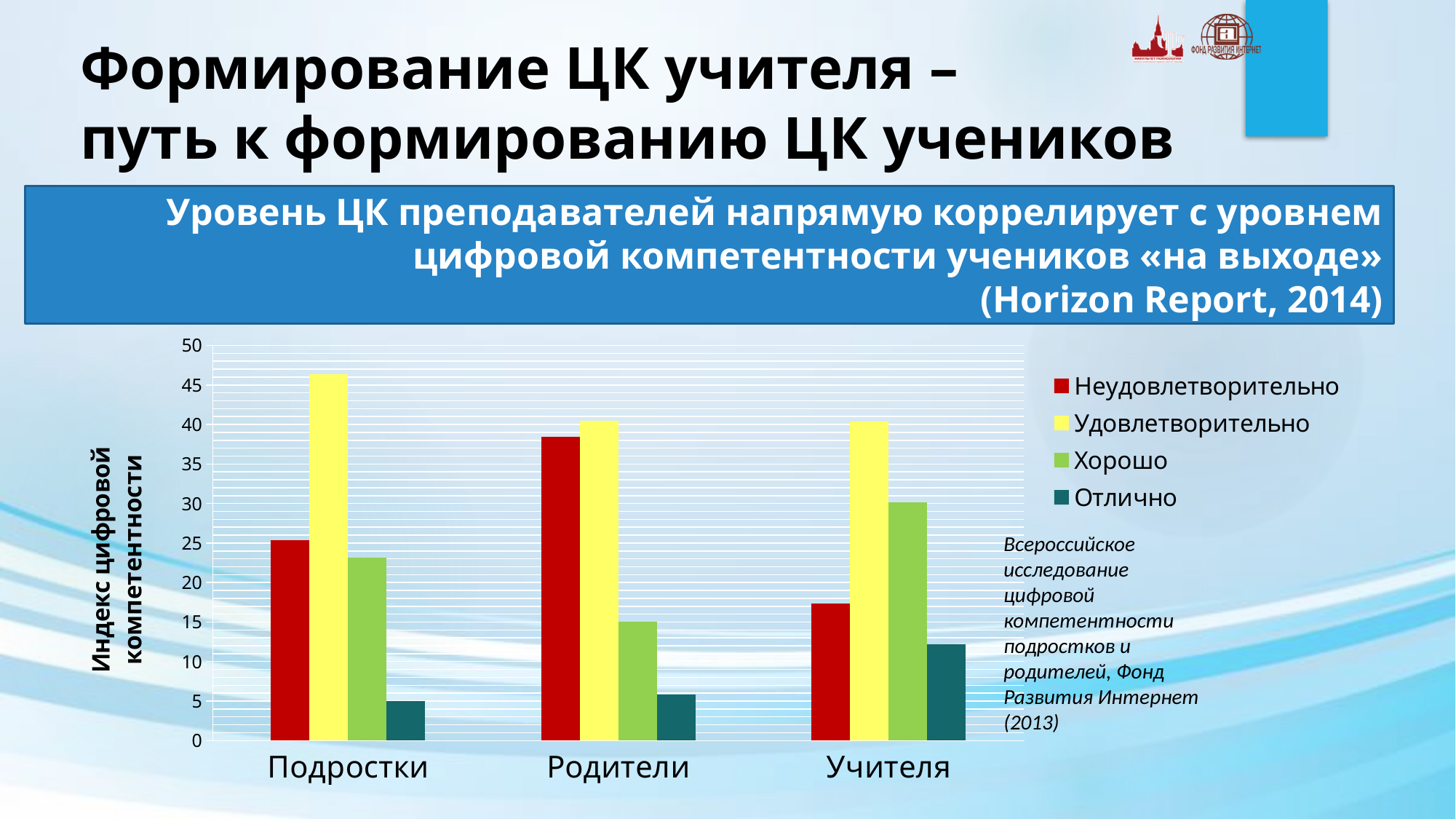
What is the label on the vertical axis of the chart? Индекс цифровой компетентности How many series does the chart legend list? 4 Is the value for Хорошо in the Учителя group greater or less than 25? greater Is the value for Неудовлетворительно in the Родители group greater or less than 35? greater How many categories are shown on the x axis of the chart? 3 Which category has the highest value for the Удовлетворительно series? Подростки Is the value for Удовлетворительно in the Подростки group greater or less than 40? greater Which category has the lowest value for the Неудовлетворительно series? Учителя Which category has the highest value for the Отлично series? Учителя What kind of chart is shown on the slide? bar chart Which is larger: the Хорошо value for Подростки or the Хорошо value for Учителя? Учителя